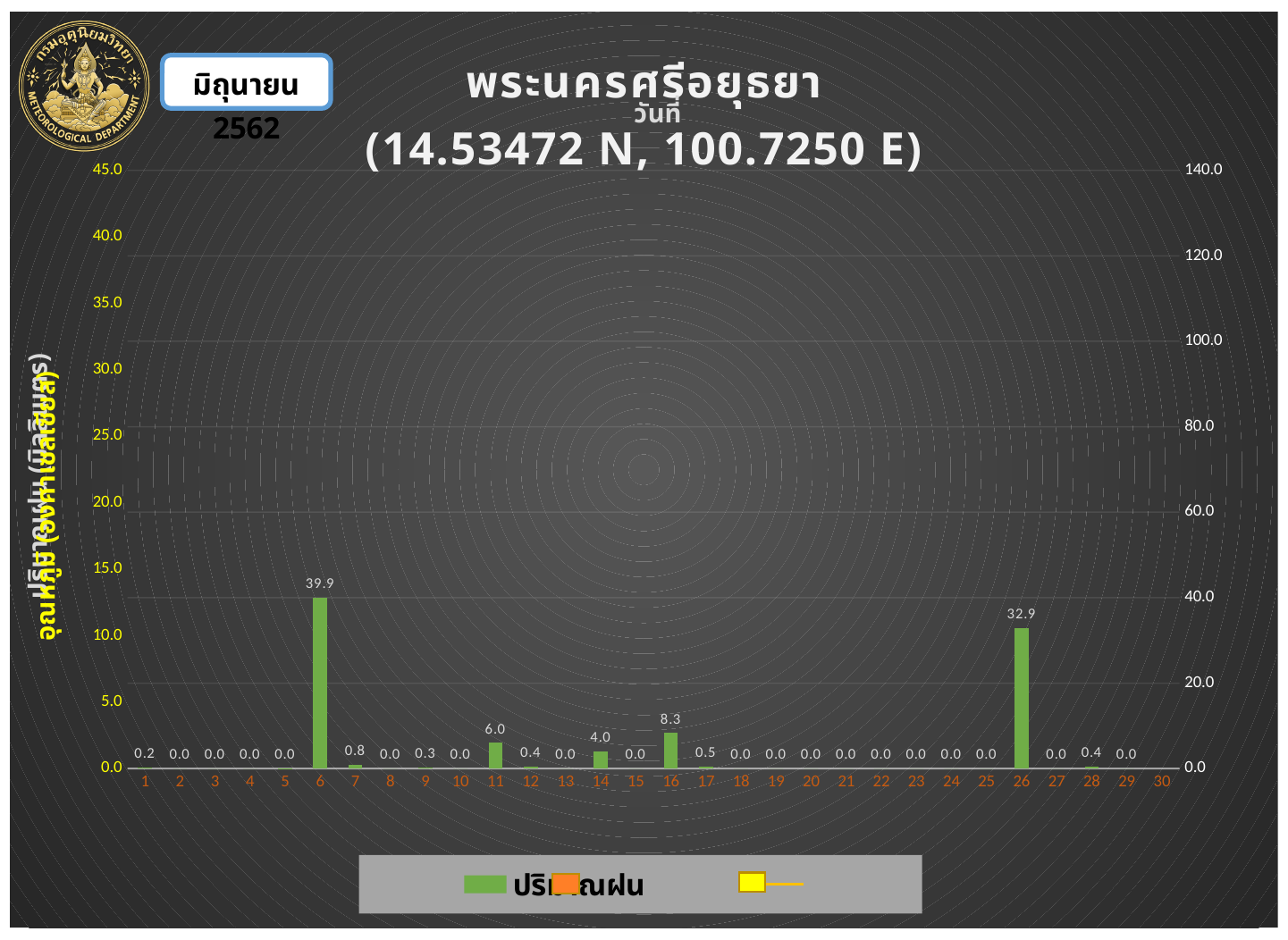
What is the rainfall value shown for day 11? 6.0 What kind of chart is shown on the slide? bar chart Which day has the highest rainfall value? 6 What is the rainfall value shown for day 14? 4.0 Which day has the larger rainfall value, day 11 or day 14? 11 Is the rainfall value for day 6 greater or less than 20.0 on the right axis? greater What is the rainfall value shown for day 26? 32.9 What is the difference between the rainfall values for day 6 and day 26? 7.0 How many days are shown on the x axis? 30 What is the rainfall value shown for day 6? 39.9 What is the rainfall value shown for day 16? 8.3 What colour are the rainfall (ปริมาณฝน) bars? green